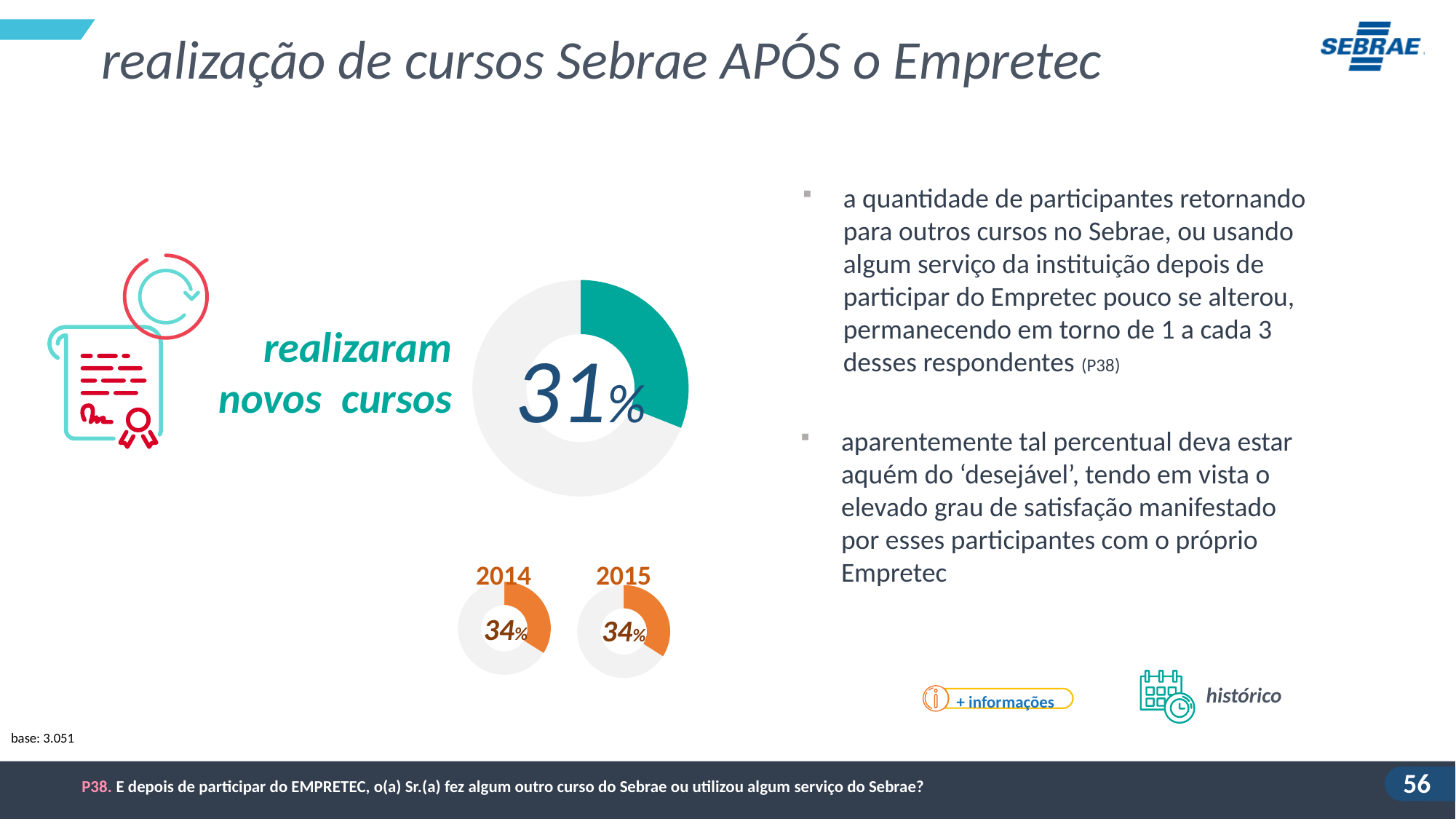
Is the value in the 2014 donut chart larger than, smaller than, or equal to the value in the 2015 donut chart? Equal What is the difference between the 2015 value (34%) and the large donut chart value (31%)? 3% What percentage of respondents is shown in the large donut chart as having taken new courses ("realizaram novos cursos")? 31% What colour is the highlighted segment in the large donut chart? Teal (green) In the small donut chart labelled 2014, what value is shown? 34% What kind of chart is used to show the 31% value? Donut (pie) chart In the small donut chart labelled 2015, what value is shown? 34% Which years are labelled on the two small donut charts? 2014 and 2015 How many small donut charts with year labels are shown below the large donut chart? 2 Is the value in the large donut chart greater or less than 50%? less What is the base (number of respondents) stated on the slide? 3.051 Did the value fall or rise from the 2014/2015 charts (34%) to the current large donut chart (31%)? Fell